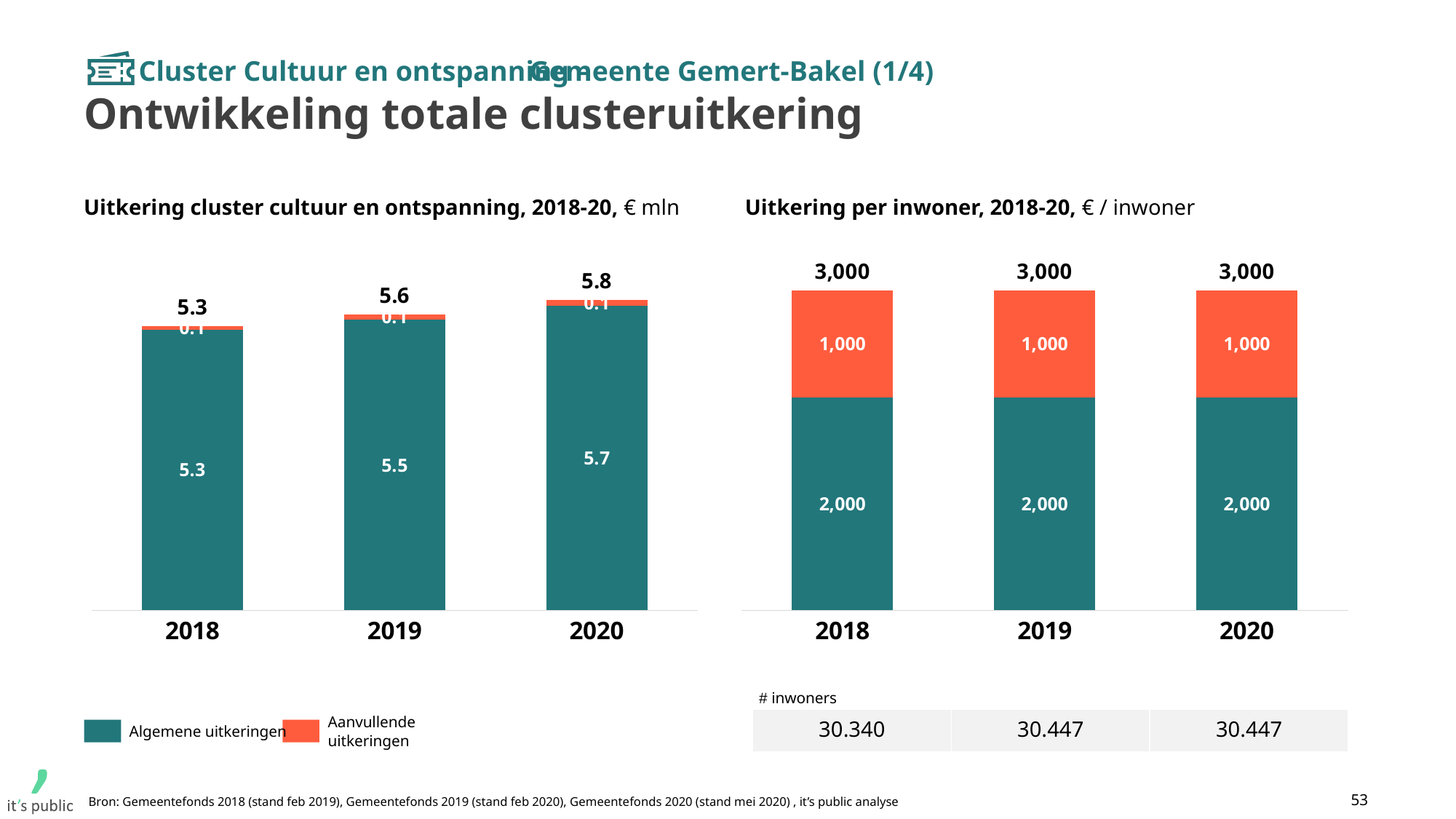
In the chart 'Uitkering per inwoner, 2018-20', what is the total of the stacked bar for 2019? 3,000 In the chart 'Uitkering cluster cultuur en ontspanning, 2018-20', what is the total uitkering for 2020? 5.8 In the chart 'Uitkering per inwoner, 2018-20', which series is shown in orange according to the legend? Aanvullende uitkeringen In the chart 'Uitkering cluster cultuur en ontspanning, 2018-20', what is the difference between the total for 2020 and the total for 2018? 0.5 What kind of chart is 'Uitkering per inwoner, 2018-20'? stacked bar chart In the chart 'Uitkering cluster cultuur en ontspanning, 2018-20', which year has the highest total uitkering? 2020 In the chart 'Uitkering cluster cultuur en ontspanning, 2018-20', do the total values rise or fall from 2018 to 2020? rise In the chart 'Uitkering cluster cultuur en ontspanning, 2018-20', which year has the lowest total uitkering? 2018 How many series does the legend of the left chart list? 2 In the chart 'Uitkering cluster cultuur en ontspanning, 2018-20', what is the value of Algemene uitkeringen in 2019? 5.5 In the chart 'Uitkering cluster cultuur en ontspanning, 2018-20', how many years are shown on the x axis? 3 In the chart 'Uitkering per inwoner, 2018-20', what is the value of Algemene uitkeringen in 2018? 2,000